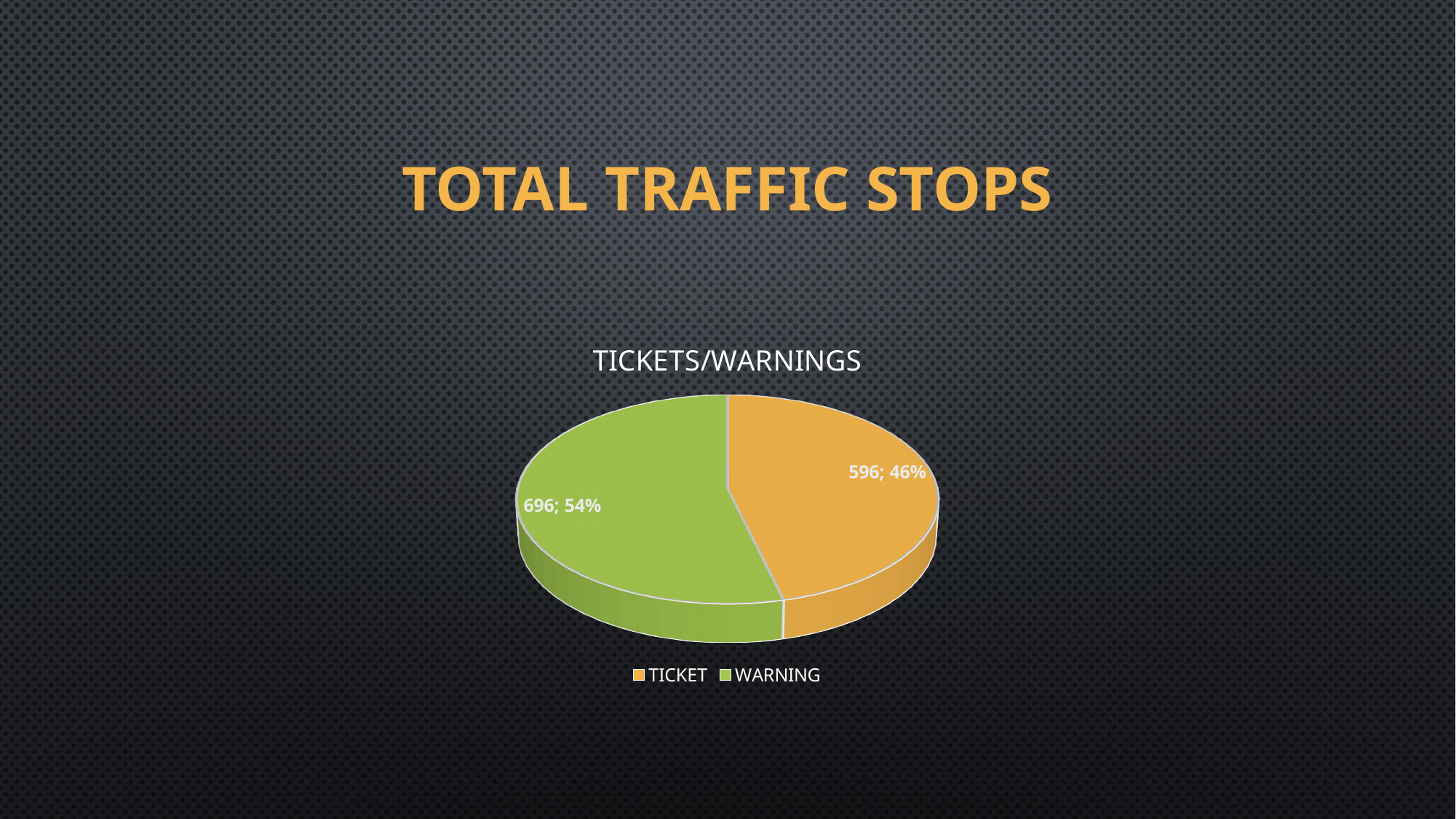
What is the value for TICKET? 596 Which category has the largest slice? WARNING How many slices does the pie chart have? 2 Which category has the smallest slice? TICKET What is the value for WARNING? 696 How many entries does the legend list? 2 What kind of chart is shown on the slide? Pie chart What is the difference between the WARNING and TICKET values? 100 What is the title of the chart? TICKETS/WARNINGS What share of the pie does the WARNING slice represent? 54% What share of the pie does the TICKET slice represent? 46% What is the total of the TICKET and WARNING values? 1292